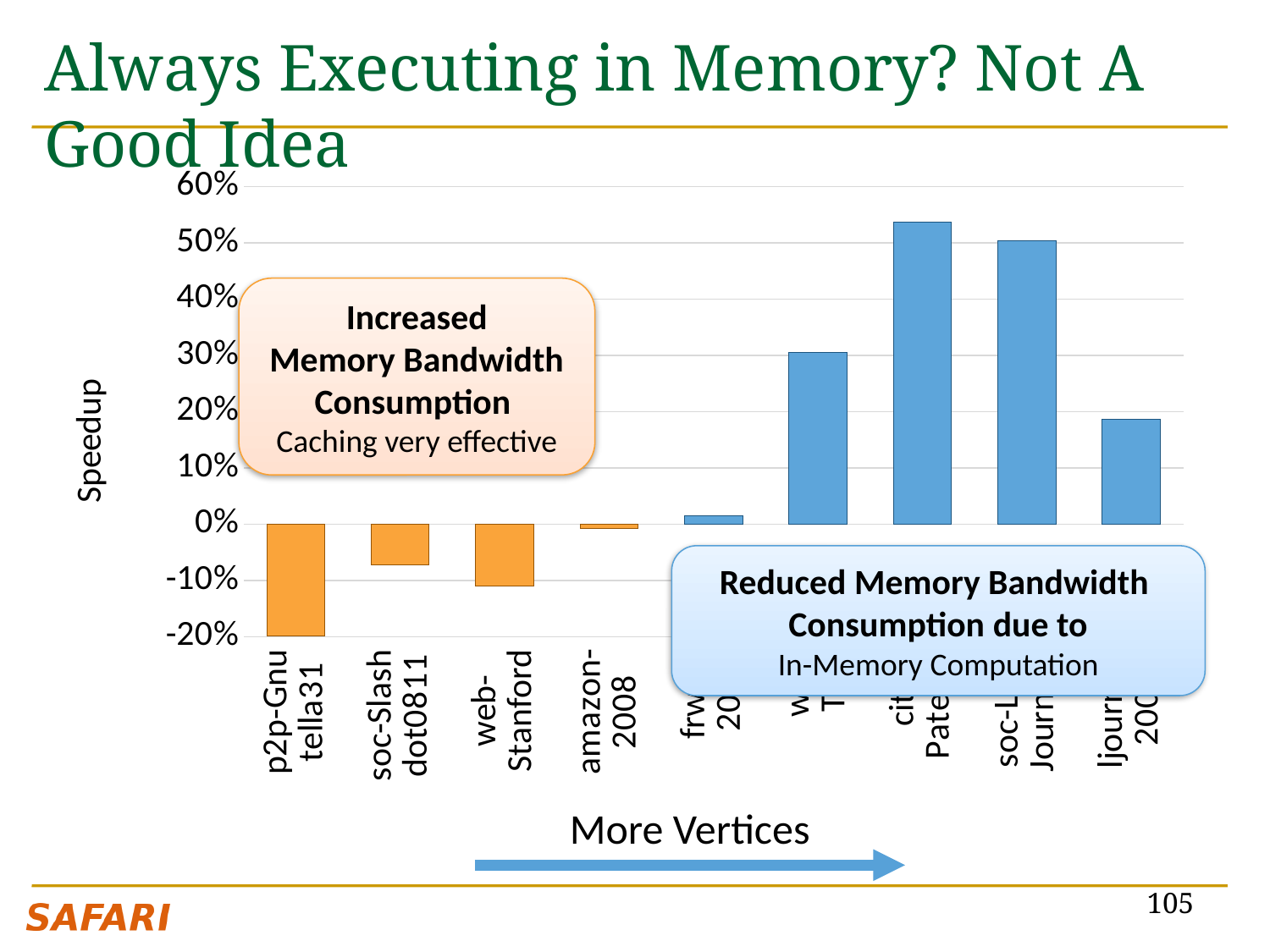
What is the label of the vertical axis of the chart? Speedup Is the speedup for p2p-Gnutella31 greater or less than -10%? less Is the speedup for amazon-2008 greater or less than -10%? greater Which has the lower speedup, p2p-Gnutella31 or web-Stanford? p2p-Gnutella31 Which category has the lowest speedup in the chart? p2p-Gnutella31 Is the highest speedup shown in the chart greater or less than 50%? greater How many bars (categories) are plotted in the chart? 9 What kind of chart is shown on the slide? bar chart What colour are the bars with negative speedup values? orange Which has the lower speedup, soc-Slashdot0811 or amazon-2008? soc-Slashdot0811